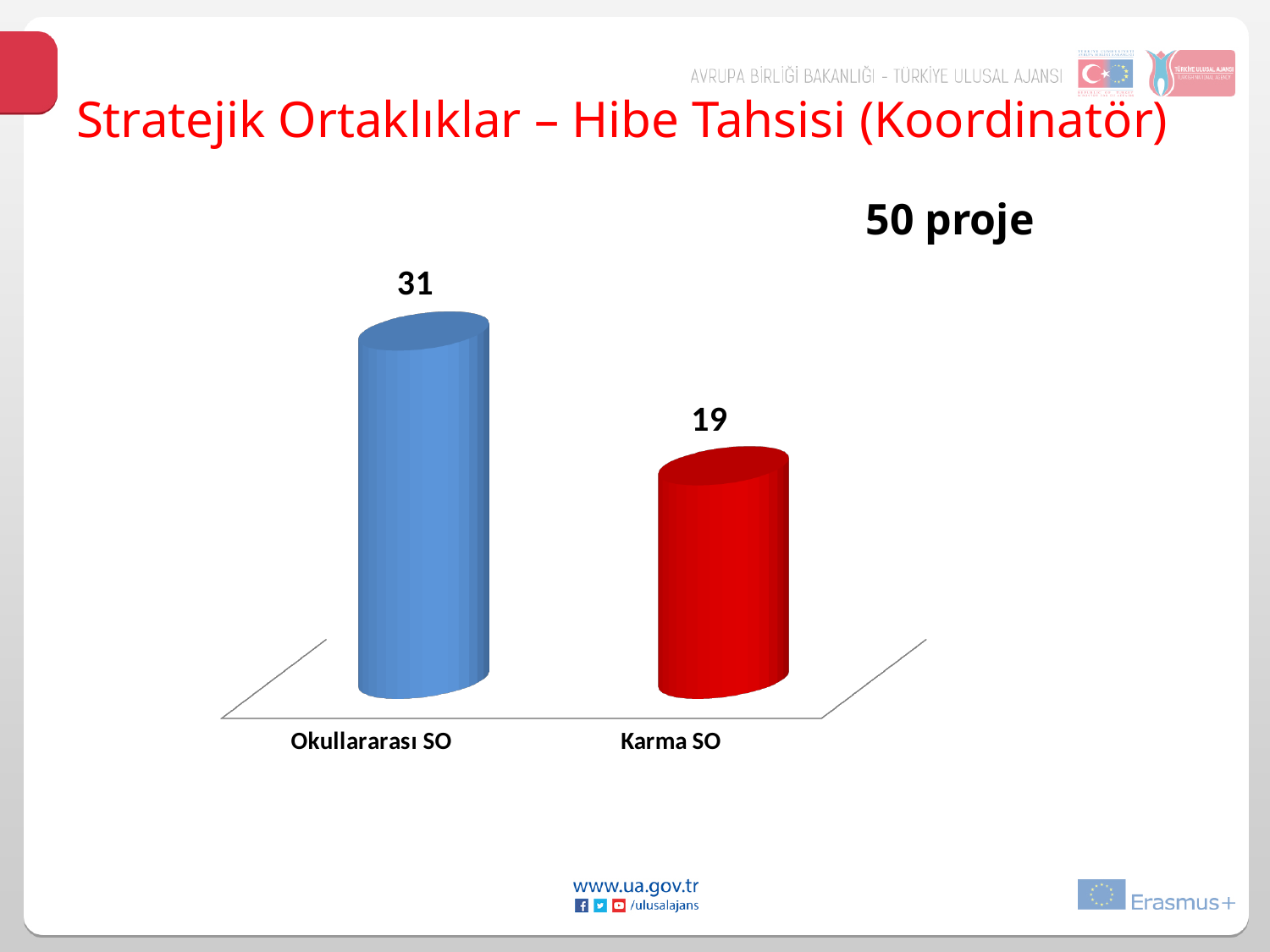
How many categories are shown in the chart? 2 What is the value for Okullararası SO? 31 What kind of chart is shown on the slide? Bar chart What is the total of the two values shown in the chart? 50 What colour is the bar for Karma SO? Red What total number of projects is stated on the slide? 50 proje What is the difference between the values for Okullararası SO and Karma SO? 12 What is the value for Karma SO? 19 Which category has the highest value? Okullararası SO Which is larger, the value for Okullararası SO or the value for Karma SO? Okullararası SO Which category has the lowest value? Karma SO